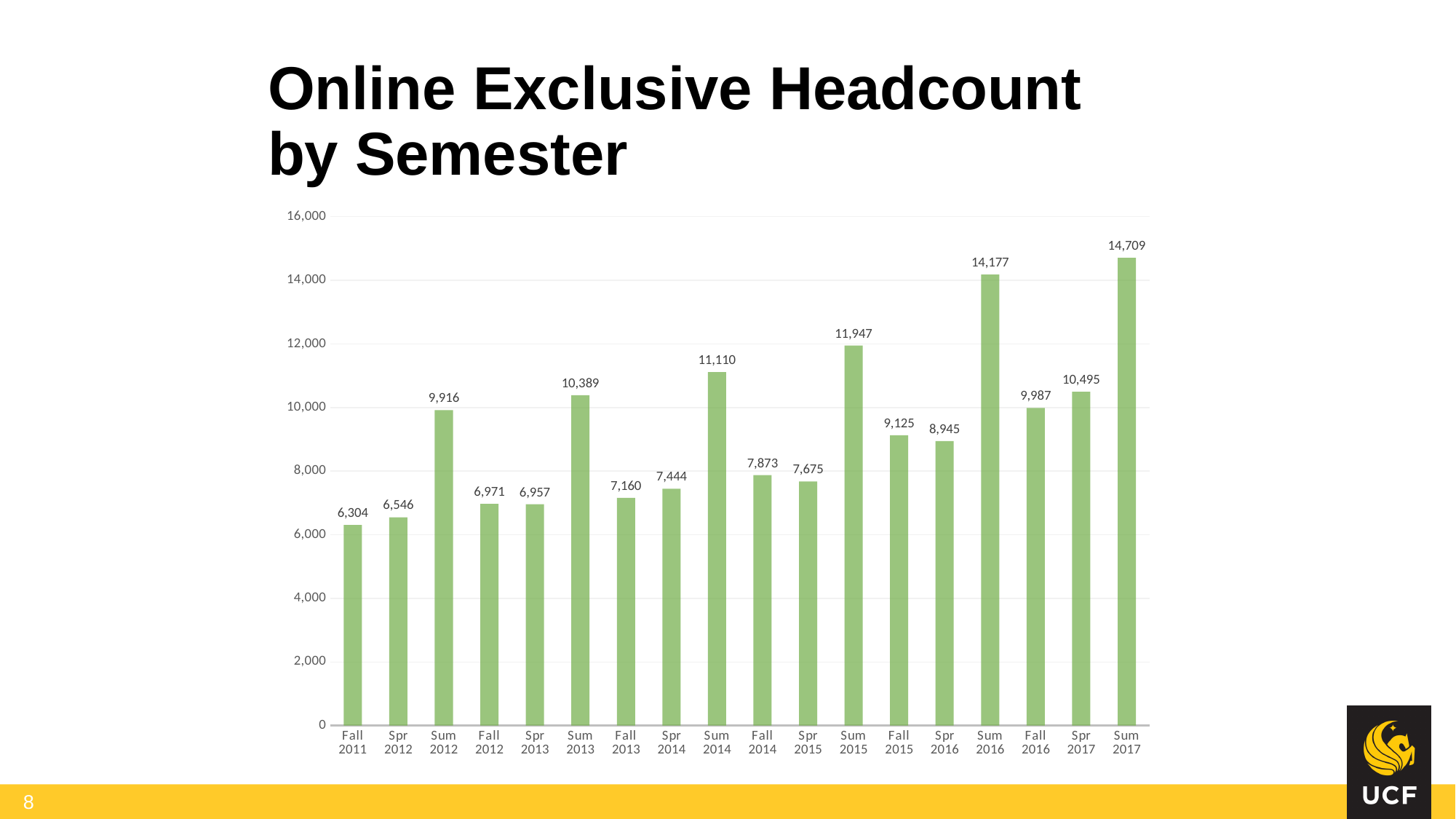
Which semester has the highest online exclusive headcount? Sum 2017 What kind of chart is shown on the slide? Bar chart Which semester has the lowest online exclusive headcount? Fall 2011 What is the difference in headcount between Fall 2016 and Fall 2015? 862 What is the difference in headcount between Sum 2017 and Sum 2016? 532 What is the online exclusive headcount for Spr 2016? 8,945 How many semesters are shown on the chart? 18 Which has a larger headcount, Sum 2015 or Sum 2014? Sum 2015 Is the value for Spr 2017 greater or less than 10,000? greater What is the online exclusive headcount for Fall 2011? 6,304 What is the online exclusive headcount for Sum 2014? 11,110 What is the title of the slide? Online Exclusive Headcount by Semester